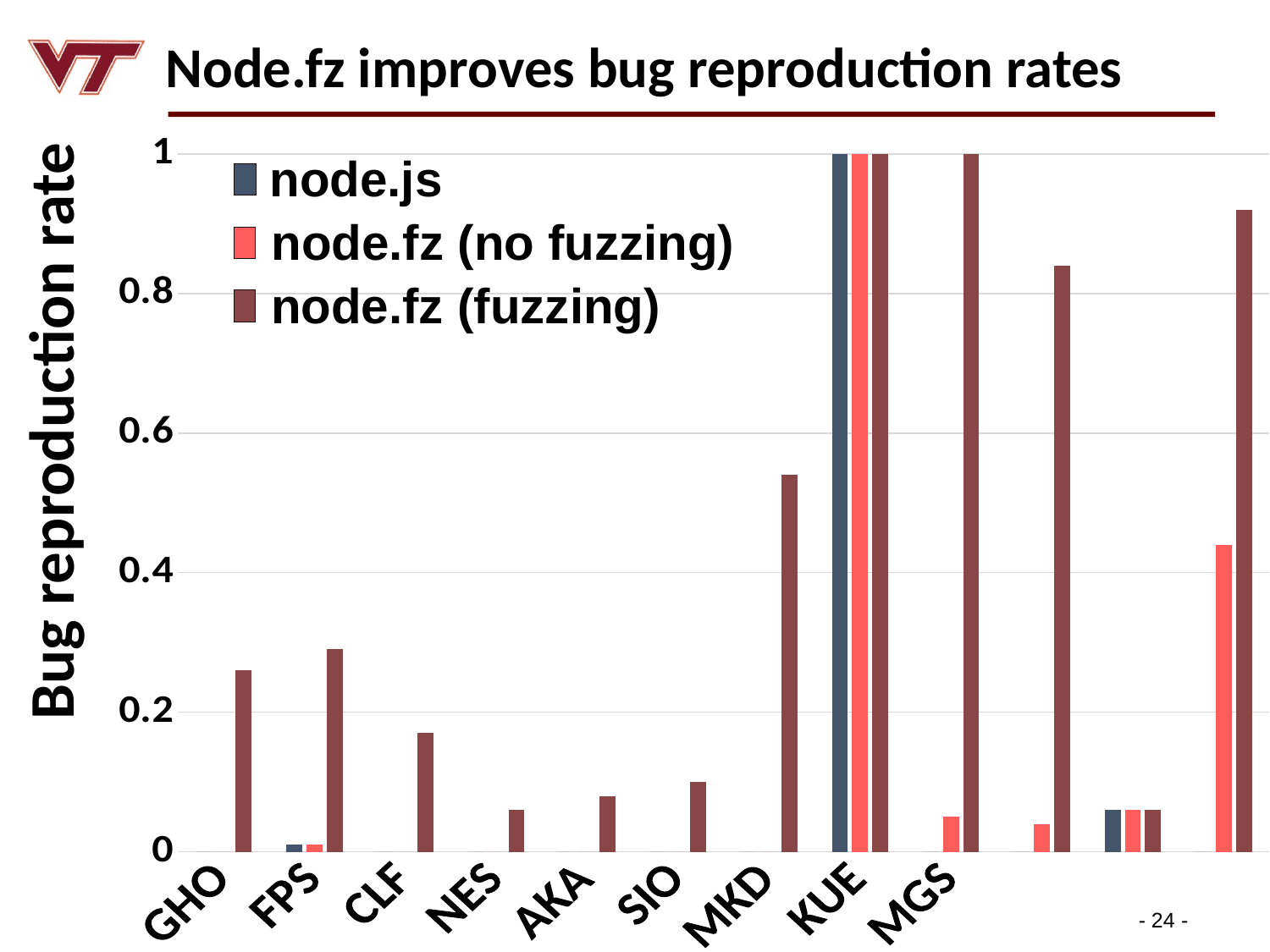
What is the label of the y axis? Bug reproduction rate What is the node.fz (fuzzing) bug reproduction rate for MGS? 1 Is the node.fz (fuzzing) value for MKD greater or less than 0.4? greater Which is larger, the node.fz (fuzzing) value for GHO or for CLF? GHO What is the node.fz (no fuzzing) bug reproduction rate for KUE? 1 What is the node.js bug reproduction rate for KUE? 1 Which category has the highest node.js bug reproduction rate? KUE How many series does the legend list? 3 What kind of chart is shown on the slide? bar chart Is the node.fz (fuzzing) value for GHO greater or less than 0.2? greater Is the node.fz (fuzzing) value for CLF greater or less than 0.2? less Which is larger, the node.fz (fuzzing) value for MKD or for FPS? MKD